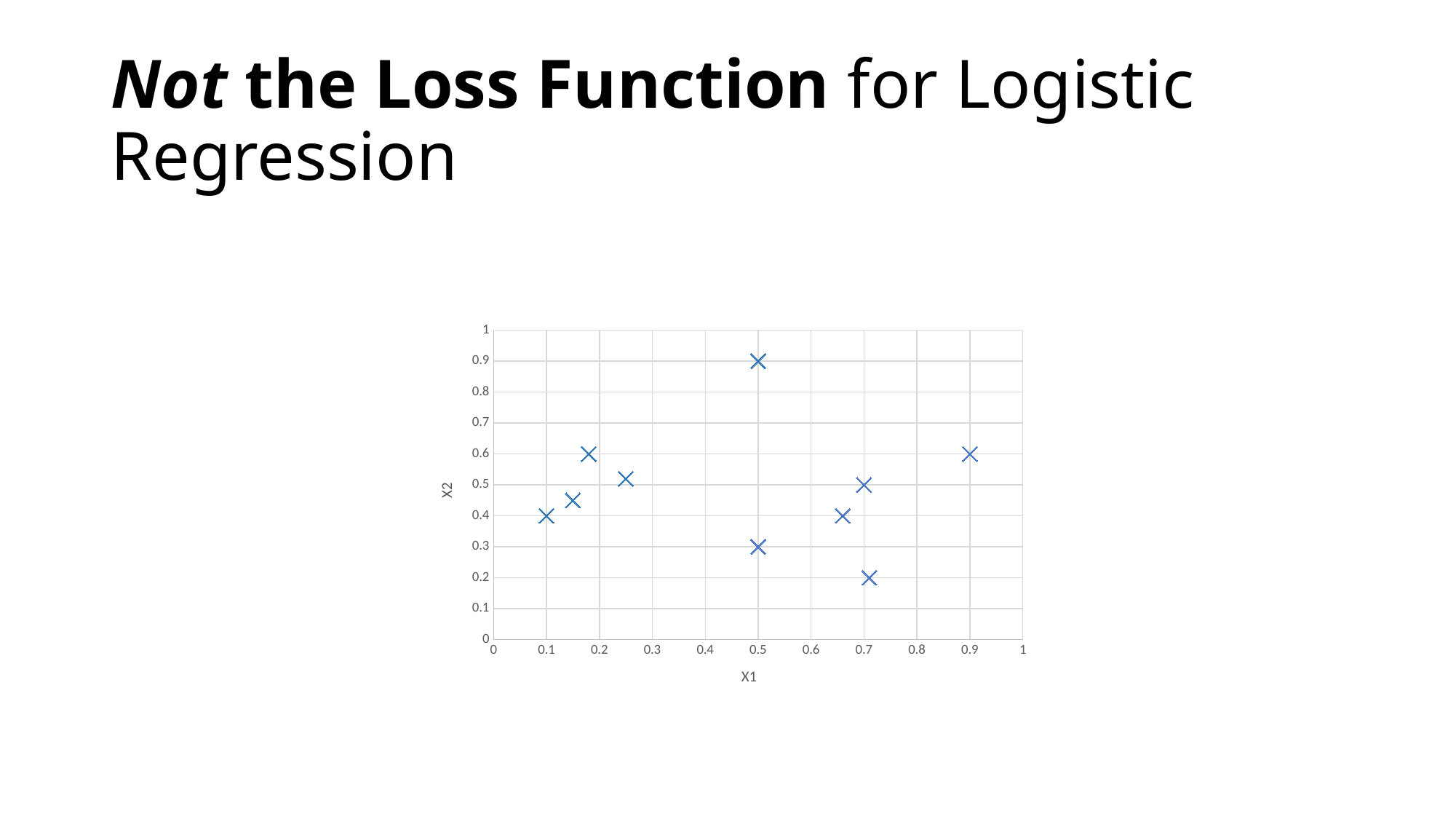
What is the X2 value of the lowest point on the chart? 0.2 Is the X2 value of the lowest point at X1 = 0.5 greater or less than 0.4? less What kind of chart is shown on the slide? scatter plot Which of the two points at X1 = 0.5 has the larger X2 value, the upper one at 0.9 or the lower one at 0.3? the upper one at 0.9 What is the X2 value of the point at X1 = 0.1? 0.4 What is the highest X2 value among the plotted points? 0.9 How many data points are plotted on the chart? 10 What is the maximum value shown on the X1 axis? 1 What is the label of the vertical axis? X2 What is the label of the horizontal axis? X1 What is the X1 value of the point with the highest X2 value? 0.5 Is the X2 value of the point at X1 = 0.9 greater or less than 0.5? greater